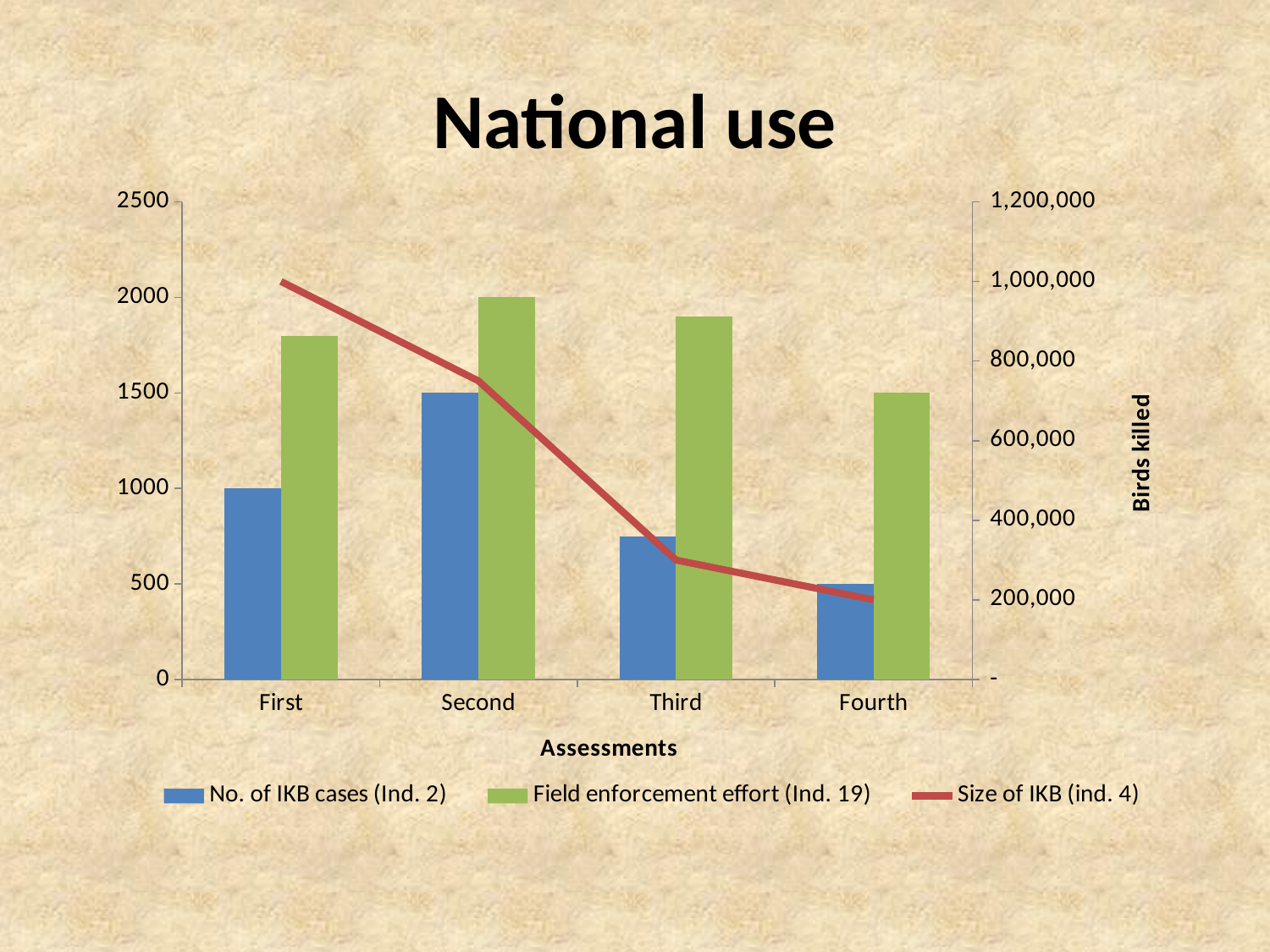
Which assessment has the highest Field enforcement effort (Ind. 19)? Second What is the label of the right-hand vertical axis? Birds killed How many series does the legend list? 3 Is the Size of IKB (ind. 4) for the Third assessment greater or less than 400,000 birds killed? less Is the value of No. of IKB cases (Ind. 2) for the Third assessment greater or less than 1000? less What is the difference in No. of IKB cases (Ind. 2) between the Second and First assessments? 500 What is the value of Field enforcement effort (Ind. 19) for the Fourth assessment? 1500 Does the Size of IKB (ind. 4) line rise or fall from the First to the Fourth assessment? fall Which assessment has the lowest No. of IKB cases (Ind. 2)? Fourth What is the value of No. of IKB cases (Ind. 2) for the First assessment? 1000 What is the value of Field enforcement effort (Ind. 19) for the Second assessment? 2000 What is the value of No. of IKB cases (Ind. 2) for the Second assessment? 1500